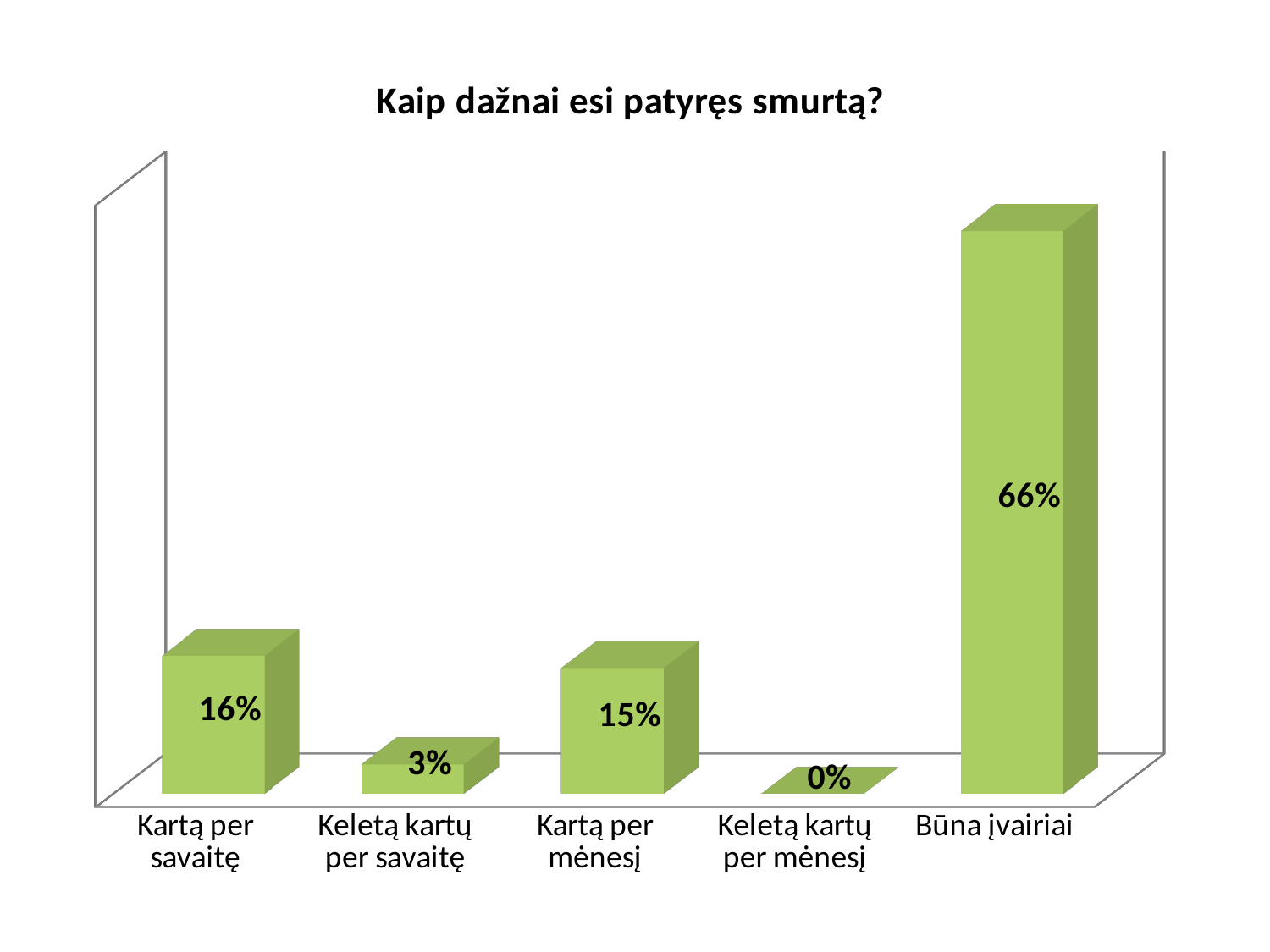
How many categories are shown in the chart? 5 What is the value for "Būna įvairiai"? 66% What is the difference between the values for "Būna įvairiai" and "Kartą per savaitę"? 50% What is the value for "Keletą kartų per mėnesį"? 0% Which category has the highest value? Būna įvairiai Which category has the lowest value? Keletą kartų per mėnesį What is the title of the chart? Kaip dažnai esi patyręs smurtą? Which is larger, the value for "Kartą per savaitę" or "Keletą kartų per savaitę"? Kartą per savaitę What is the value for "Keletą kartų per savaitę"? 3% What is the value for "Kartą per savaitę"? 16% What is the value for "Kartą per mėnesį"? 15% What kind of chart is shown on the slide? Bar chart